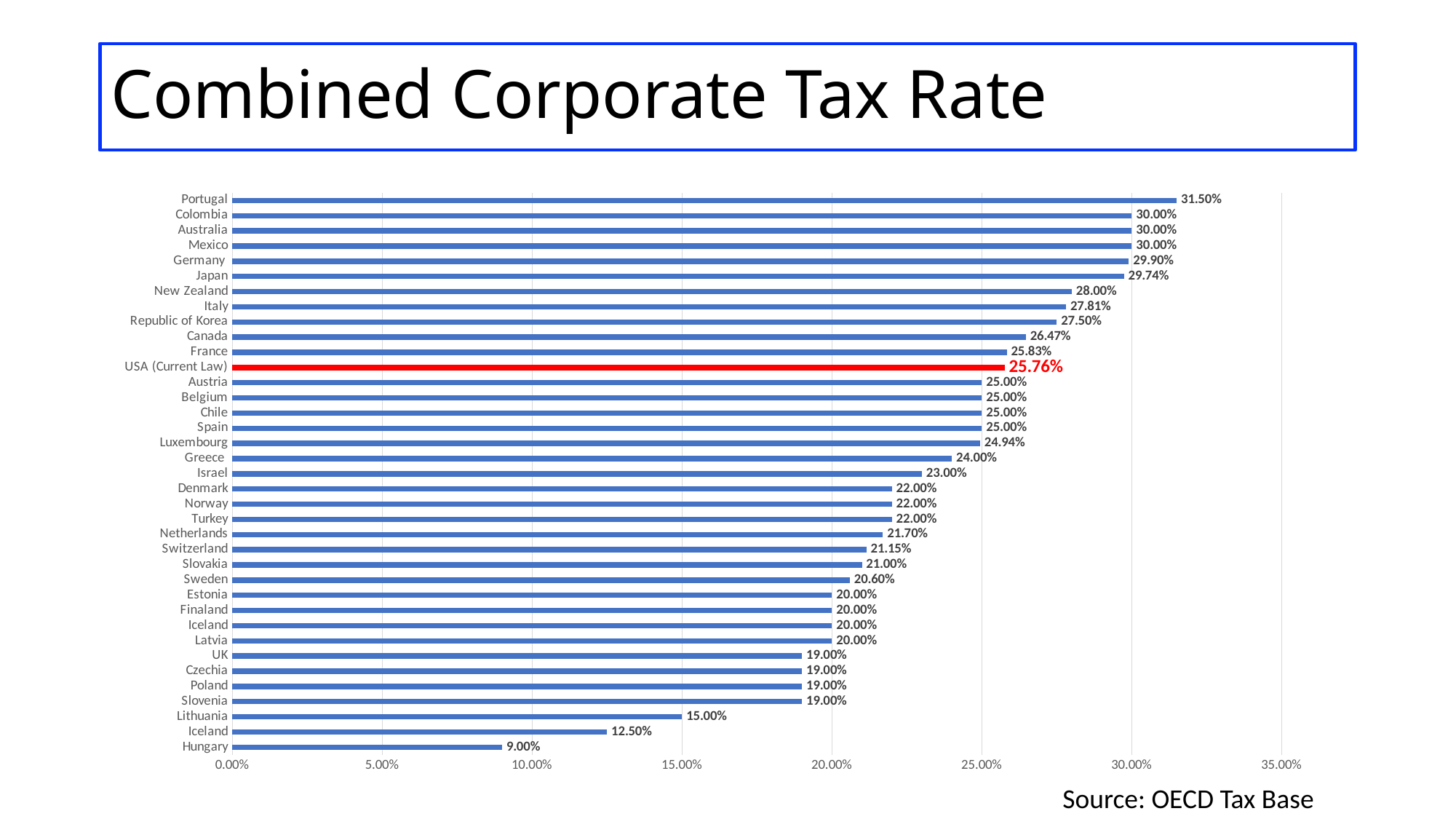
What is the value shown for USA (Current Law)? 25.76% How many countries/categories are plotted on the chart? 37 What is the difference between the rates for USA (Current Law) and France? 0.07% What kind of chart is shown on the slide? Bar chart What is the combined corporate tax rate shown for Japan? 29.74% What is the combined corporate tax rate shown for Portugal? 31.50% What is the difference between the rates for Portugal and Hungary? 22.50% Which country has the highest combined corporate tax rate on the chart? Portugal Is the value for Lithuania greater or less than 20.00%? less Which bar is highlighted in red on the chart? USA (Current Law) Which has a higher combined corporate tax rate, Canada or Germany? Germany Which country has the lowest combined corporate tax rate on the chart? Hungary